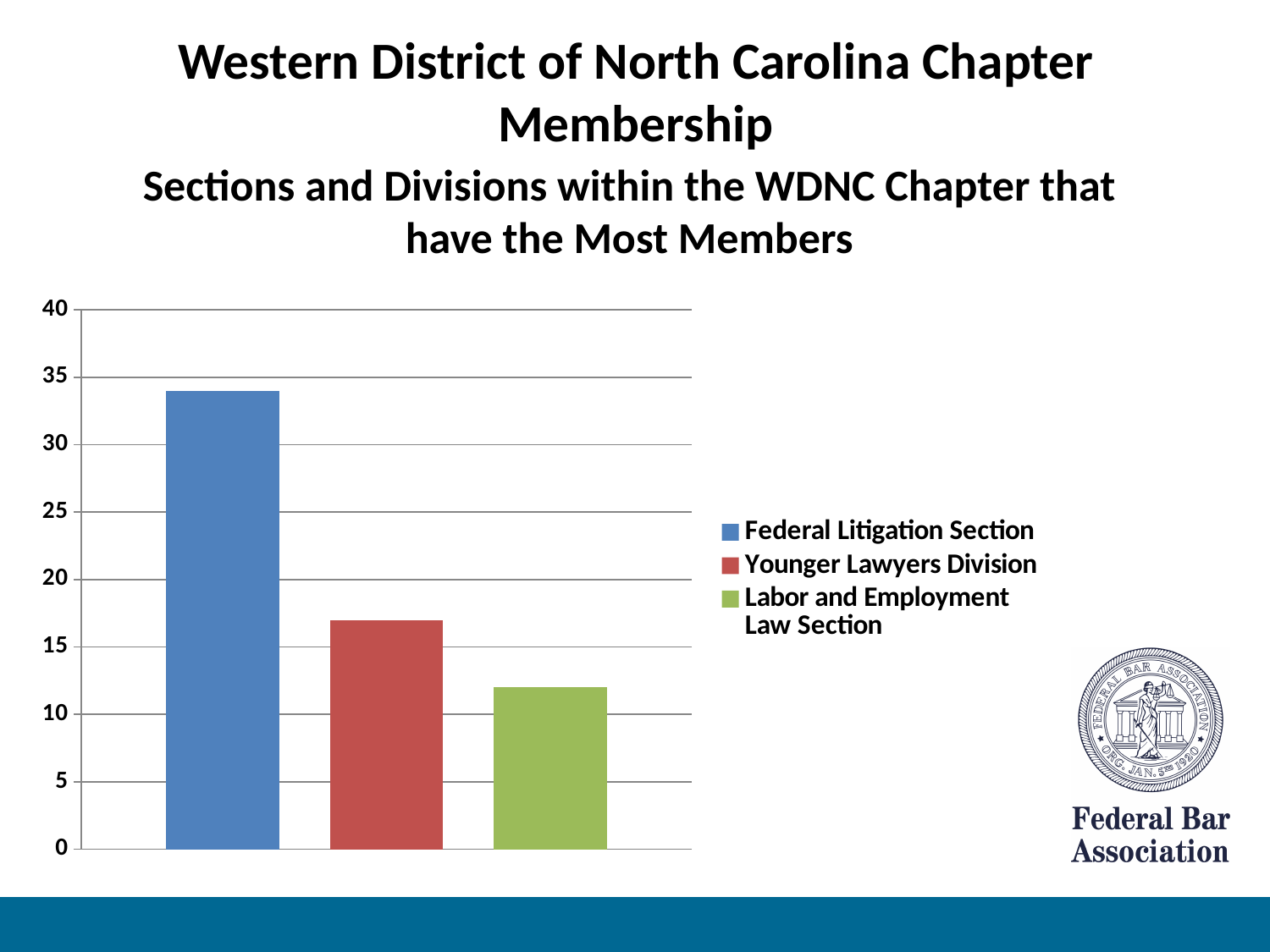
Which has more members, the Younger Lawyers Division or the Labor and Employment Law Section? Younger Lawyers Division How many series does the legend list? 3 What colour is the bar for the Younger Lawyers Division? red What kind of chart is shown on the slide? bar chart Is the value for the Federal Litigation Section greater or less than 30? greater Is the value for the Younger Lawyers Division greater or less than 15? greater Is the value for the Labor and Employment Law Section greater or less than 10? greater Which section or division has the lowest number of members? Labor and Employment Law Section Which section or division has the highest number of members? Federal Litigation Section Which has more members, the Federal Litigation Section or the Younger Lawyers Division? Federal Litigation Section